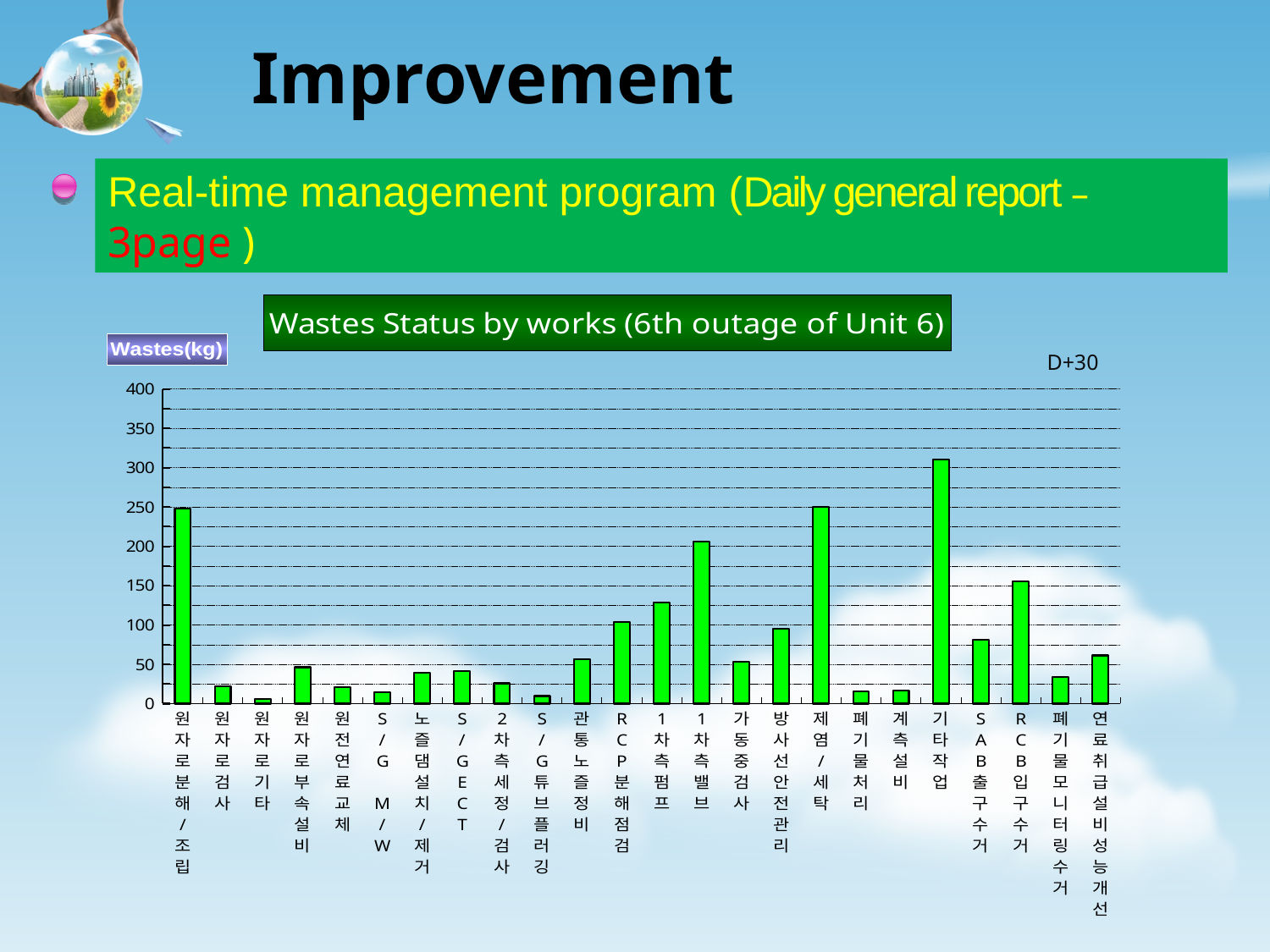
Is the value for 기타작업 greater or less than 250? greater What unit label is shown for the vertical axis of the chart? Wastes(kg) What type of chart is shown on the slide? bar chart Is the value for RCB입구수거 greater or less than 100? greater Is the value for SAB출구수거 greater or less than 100? less Which has a larger waste value, RCB입구수거 or SAB출구수거? RCB입구수거 Which work has the highest waste value? 기타작업 How many categories (works) are plotted along the x axis? 24 What is the title of the chart? Wastes Status by works (6th outage of Unit 6) Which has a larger waste value, 1차측밸브 or 1차측펌프? 1차측밸브